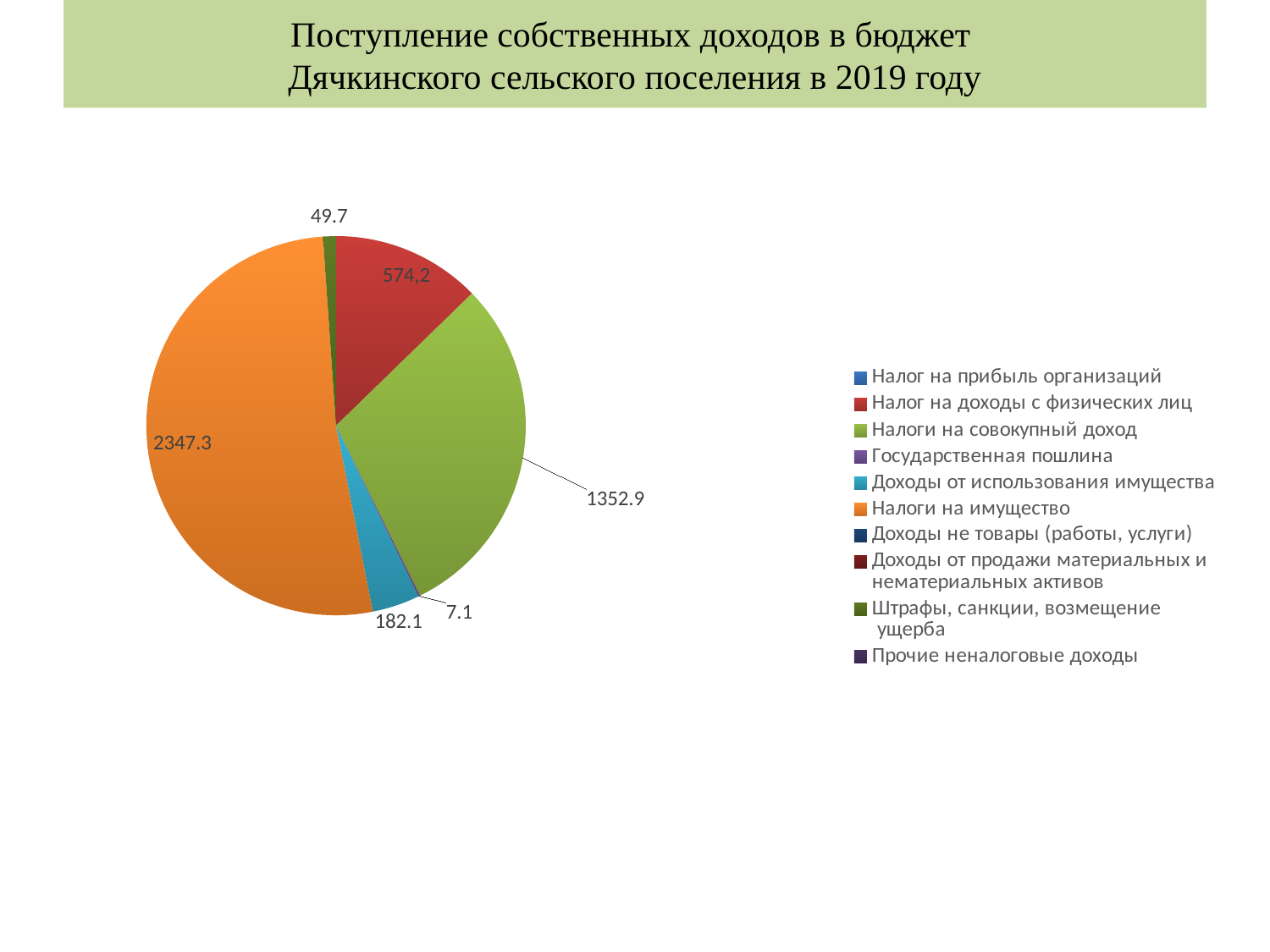
What is the value of the slice for Налоги на совокупный доход? 1352.9 How many categories are listed in the legend? 10 What is the value of the slice for Налог на доходы с физических лиц? 574,2 What is the difference between the values for Налоги на имущество and Налоги на совокупный доход? 994.4 What type of chart is shown on the slide? pie chart Which category has the largest slice of the pie? Налоги на имущество What is the value of the slice for Штрафы, санкции, возмещение ущерба? 49.7 What is the title of the slide? Поступление собственных доходов в бюджет Дячкинского сельского поселения в 2019 году What is the value of the slice for Налоги на имущество? 2347.3 Which is larger: the slice for Доходы от использования имущества or the slice for Штрафы, санкции, возмещение ущерба? Доходы от использования имущества What is the value of the slice for Доходы от использования имущества? 182.1 What is the value of the slice for Государственная пошлина? 7.1